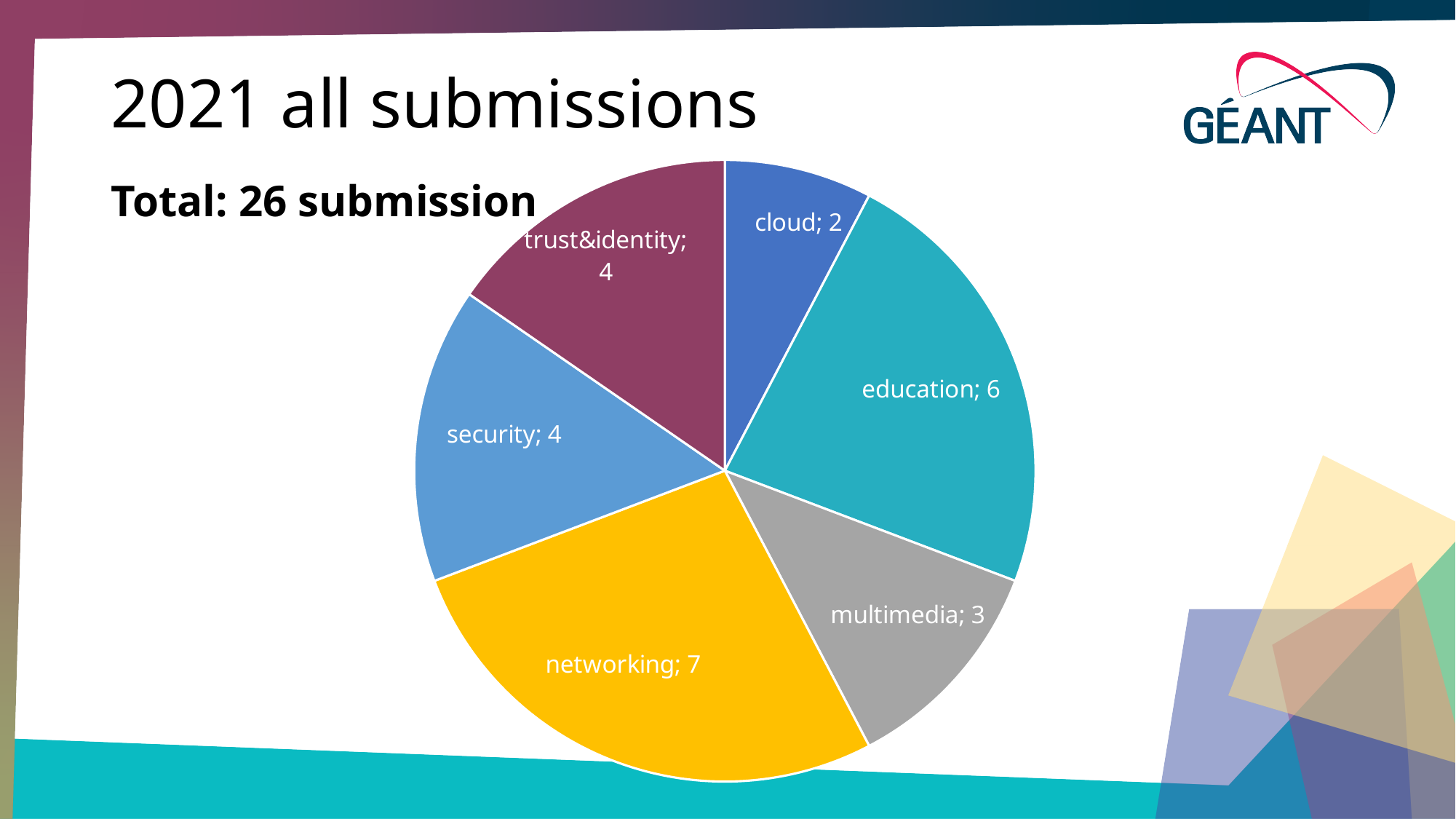
How many submissions are in the cloud category? 2 How many categories does the pie chart show? 6 What is the total number of submissions stated on the slide? 26 How many submissions are in the education category? 6 Which has more submissions, education or multimedia? education What kind of chart is shown on the slide? pie chart How many submissions are in the multimedia category? 3 Which category has the fewest submissions? cloud Which category has the most submissions? networking How many submissions are in the networking category? 7 What is the title of the slide containing the pie chart? 2021 all submissions What is the difference between the number of networking submissions and the number of cloud submissions? 5